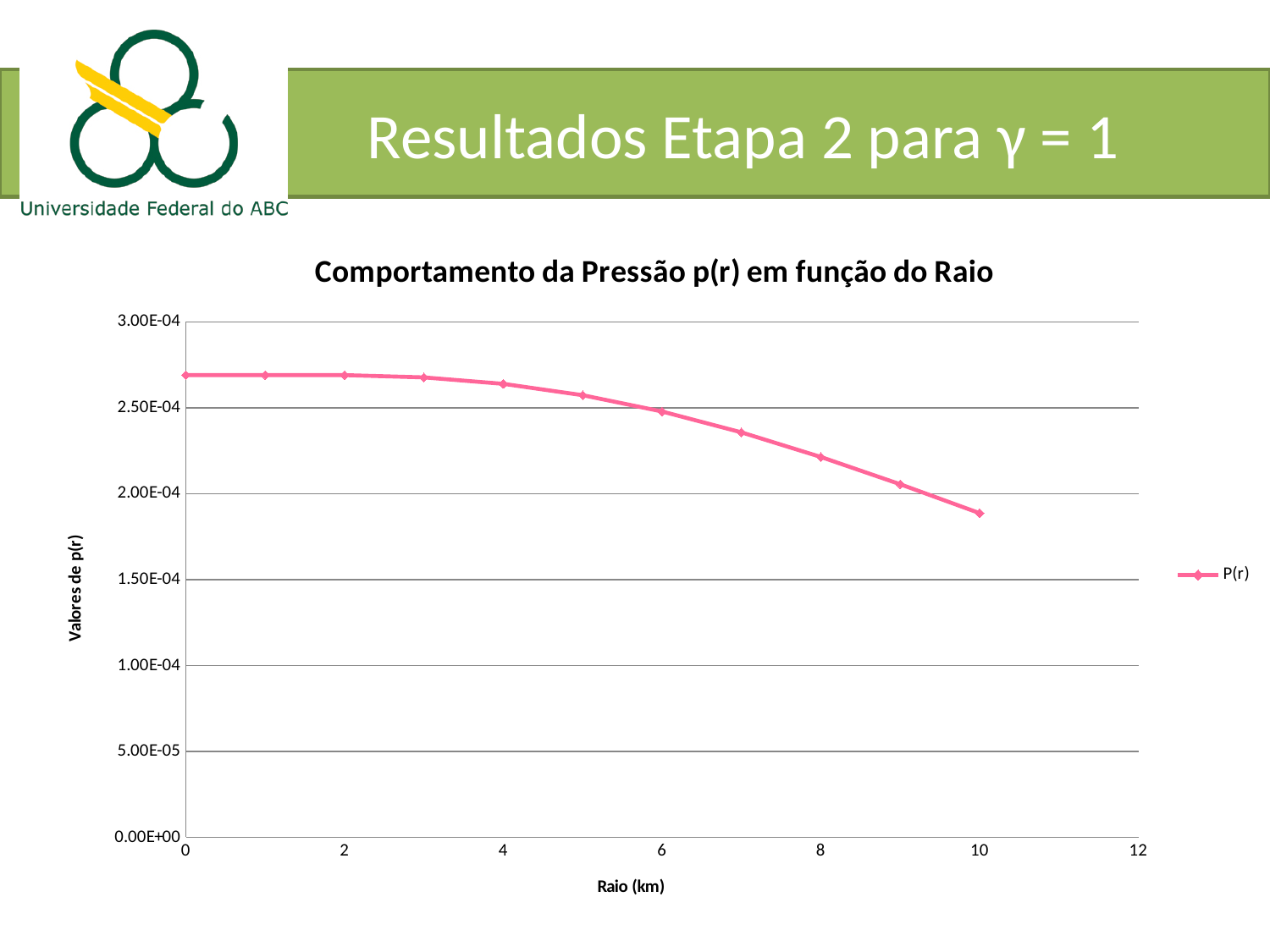
Is the value of P(r) at radius 10 greater or less than 2.00E-04? less Is the value of P(r) at radius 8 greater or less than 2.00E-04? greater How many series does the legend list? 1 At which radius value is P(r) lowest? 10 What is the name of the series shown in the legend? P(r) Is the value of P(r) at radius 7 greater or less than 2.50E-04? less What is the title of the chart? Comportamento da Pressão p(r) em função do Raio How many data points are plotted for the P(r) series? 11 Do the P(r) values rise or fall as the radius increases along the x axis? fall What kind of chart is shown on the slide? line chart Which is larger, the value of P(r) at radius 2 or at radius 10? radius 2